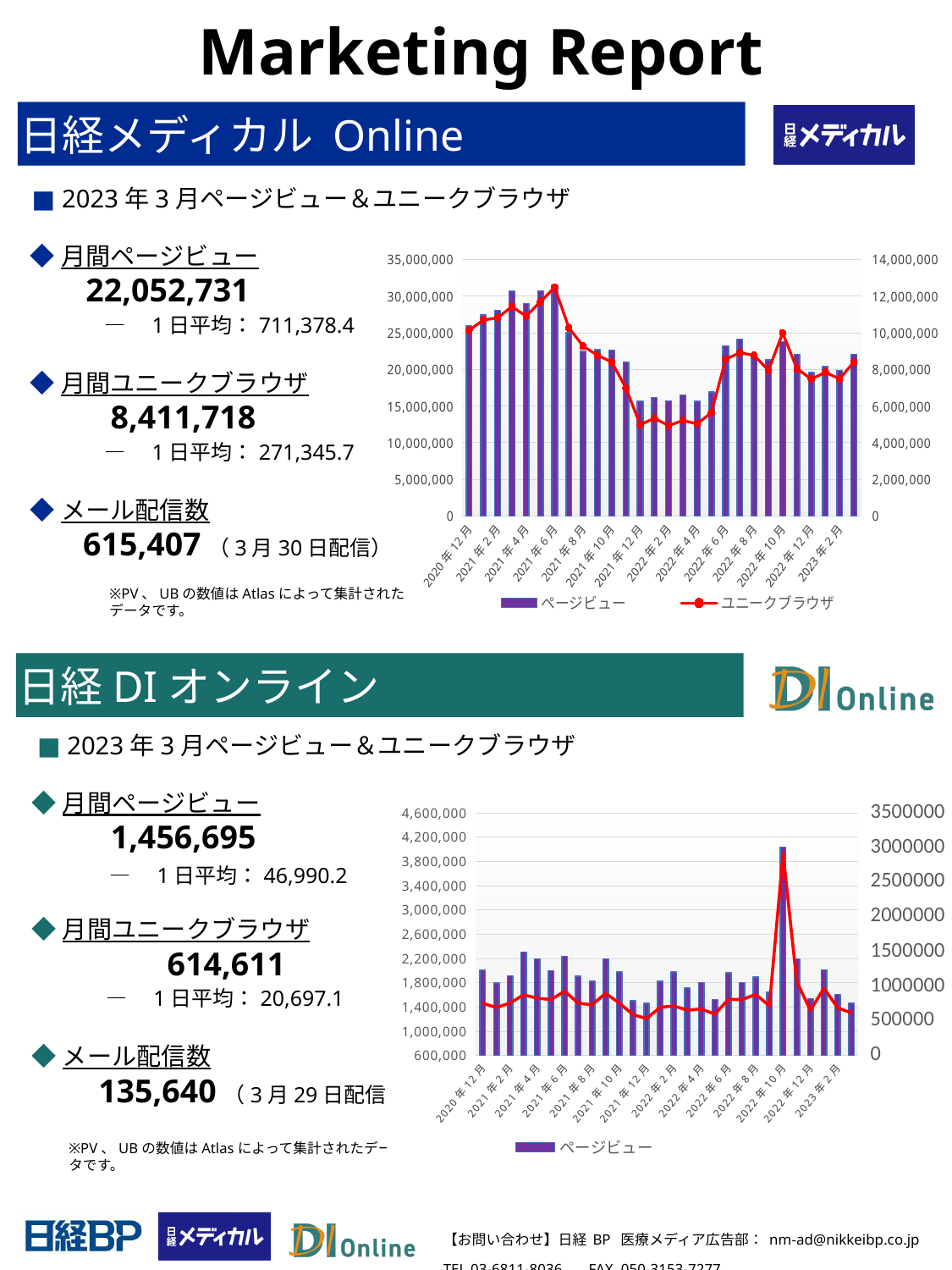
In the 日経メディカル Online chart, which has the larger ページビュー bar, 2021年6月 or 2022年2月? 2021年6月 In the 日経メディカル Online chart, what kind of chart is used to show the data? A bar chart combined with a line chart In the 日経メディカル Online chart, do the ページビュー bars rise or fall from 2021年6月 to 2022年1月? fall In the 日経メディカル Online chart, is the ページビュー value for 2021年6月 greater or less than 25,000,000? greater In the 日経 DI オンライン chart, which month has the highest ページビュー bar? 2022年10月 In the 日経メディカル Online chart, which month has the highest ページビュー bar? 2021年6月 In the 日経メディカル Online chart, what are the two legend entries? ページビュー and ユニークブラウザ In the 日経メディカル Online chart, how many series does the legend list? 2 In the 日経 DI オンライン chart, is the ページビュー value for 2022年10月 greater or less than 3,800,000? greater In the 日経メディカル Online chart, is the ページビュー value for 2022年2月 greater or less than 20,000,000? less In the 日経 DI オンライン chart, how many series does the legend list? 1